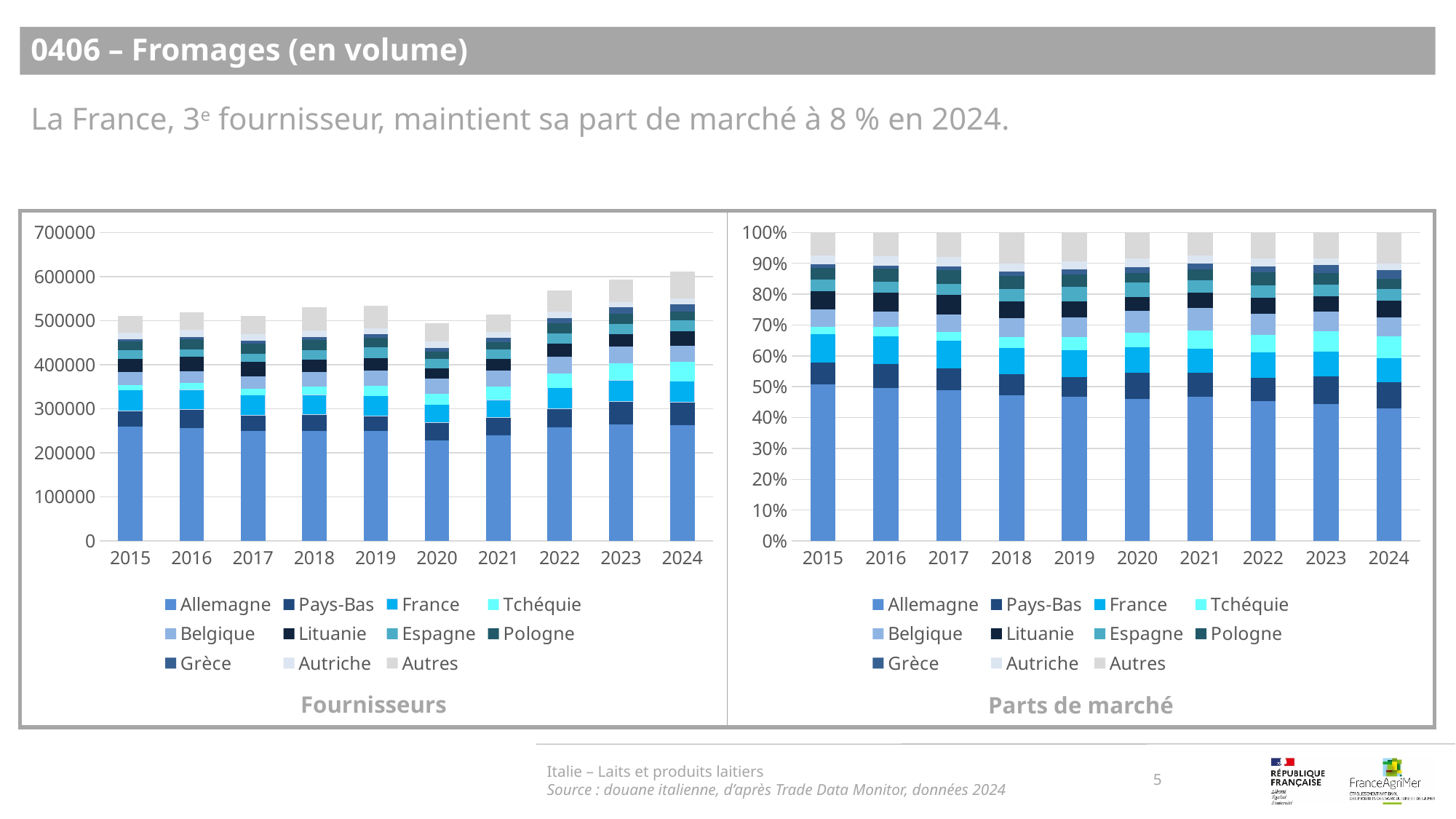
What is the title of the chart on the right of the slide? Parts de marché In the 'Fournisseurs' chart, is the total bar for 2022 larger or smaller than the total bar for 2021? larger How many series does the legend of the 'Fournisseurs' chart list? 11 In the 'Parts de marché' chart, is the share for Allemagne in 2024 greater or less than 50%? less In the 'Fournisseurs' chart, which year has the lowest total bar? 2020 Which series is listed first in the legend of the 'Fournisseurs' chart? Allemagne How many years are shown on the x axis of the 'Parts de marché' chart? 10 In the 'Parts de marché' chart, does the share for Allemagne rise or fall from 2015 to 2024? fall In the 'Fournisseurs' chart, is the total bar for 2022 greater or less than 550000? greater What kind of chart is the 'Fournisseurs' chart on the left? stacked bar chart In the 'Fournisseurs' chart, is the value for Allemagne in 2020 greater or less than 250000? less In the 'Fournisseurs' chart, which year has the highest total bar? 2024